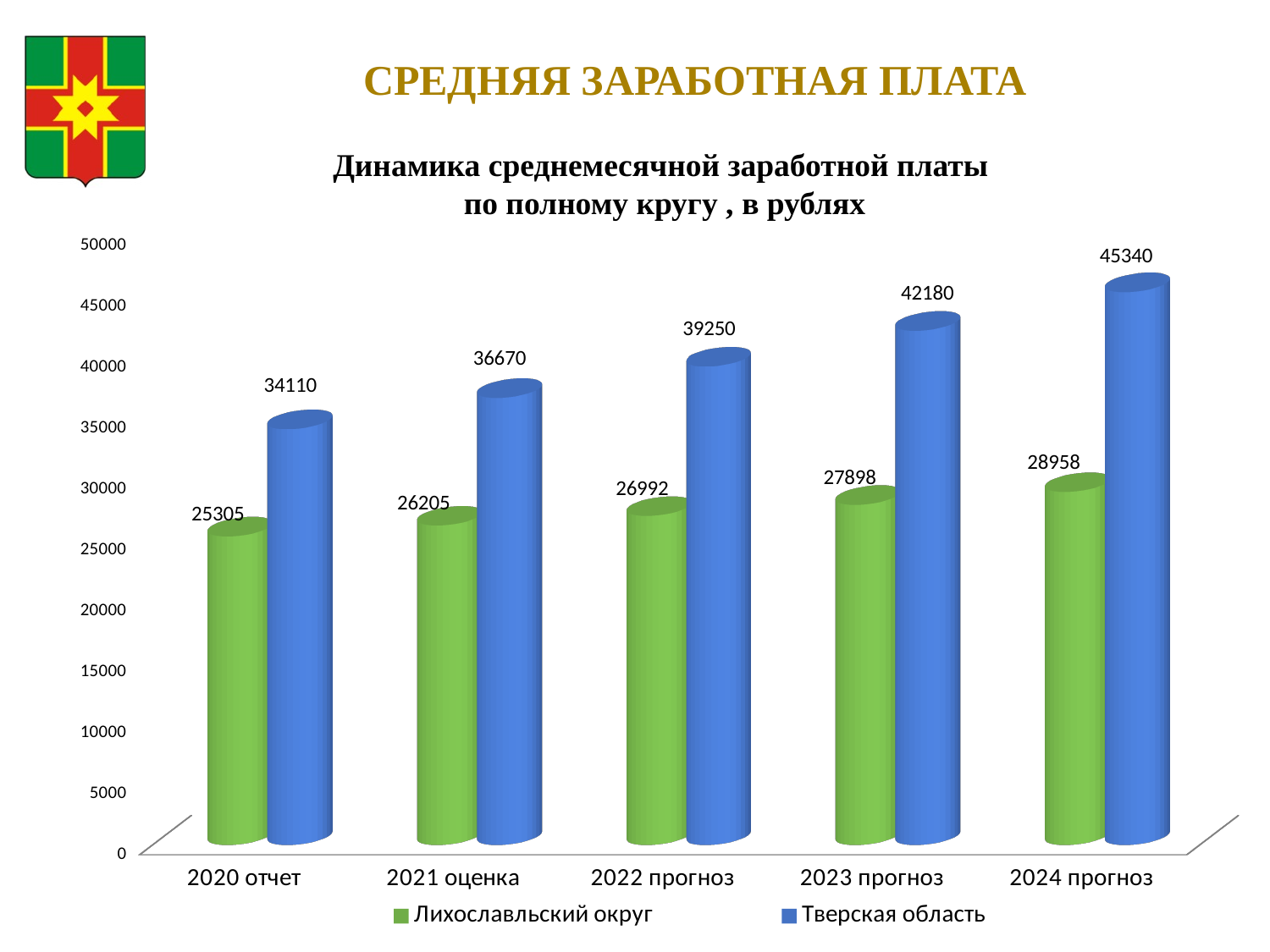
How many categories are shown on the x axis? 5 What is the value for Лихославльский округ in 2024 прогноз? 28958 Is the value for Тверская область in 2020 отчет greater or less than 30000? greater What kind of chart is shown on the slide? bar chart Do the values for Тверская область rise or fall from 2020 отчет to 2024 прогноз? rise What is the value for Тверская область in 2022 прогноз? 39250 How many series does the legend list? 2 Which is larger in 2021 оценка: Лихославльский округ or Тверская область? Тверская область Which category has the highest value for Тверская область? 2024 прогноз What is the value for Лихославльский округ in 2020 отчет? 25305 Which category has the lowest value for Лихославльский округ? 2020 отчет What is the difference between Тверская область and Лихославльский округ in 2023 прогноз? 14282